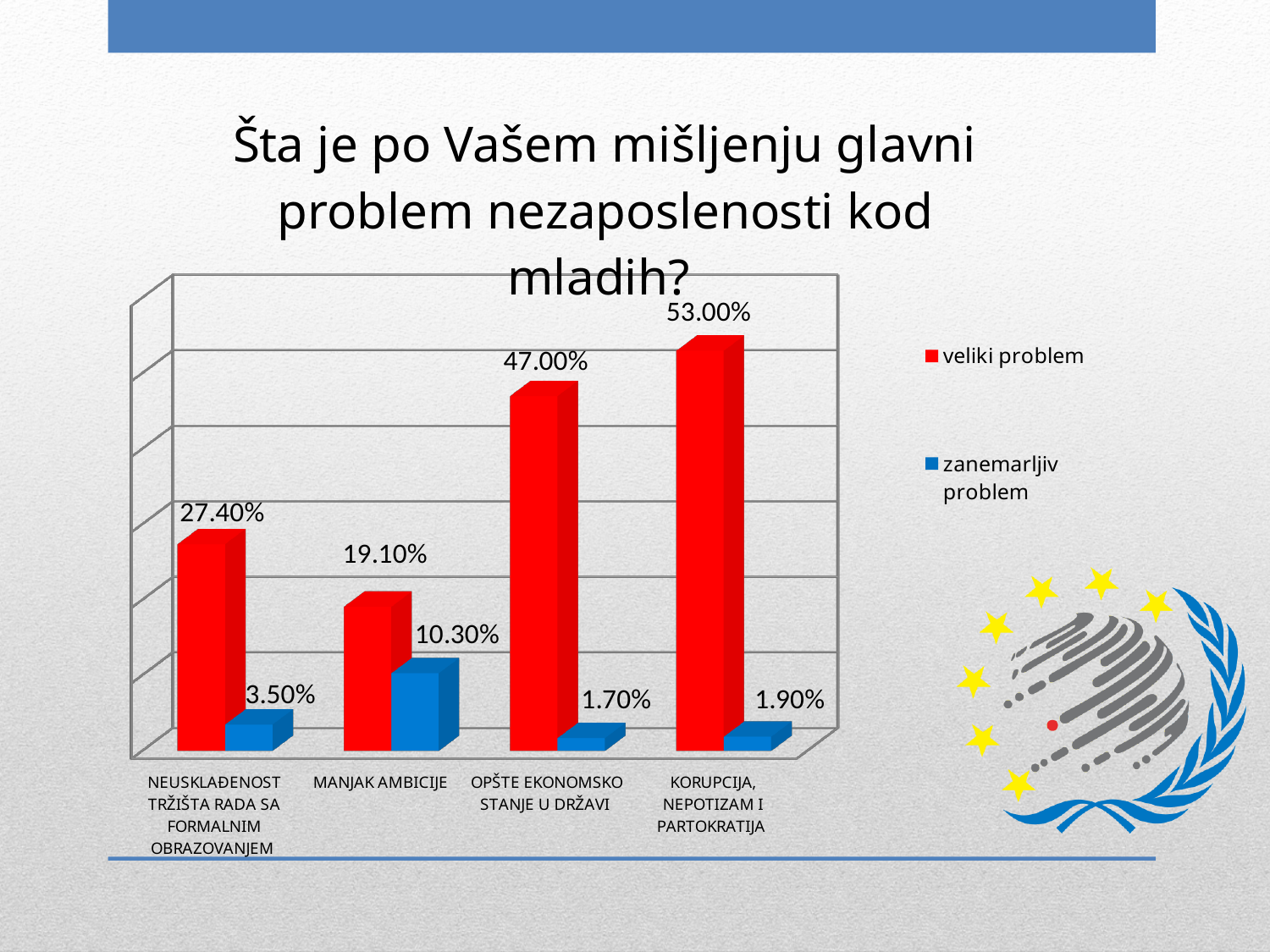
How many series does the legend list? 2 What is the value of "zanemarljiv problem" for OPŠTE EKONOMSKO STANJE U DRŽAVI? 1.70% Which colour represents the "zanemarljiv problem" series? blue How many categories are shown on the x axis? 4 Which is larger: the "veliki problem" value for MANJAK AMBICIJE or for NEUSKLAĐENOST TRŽIŠTA RADA SA FORMALNIM OBRAZOVANJEM? NEUSKLAĐENOST TRŽIŠTA RADA SA FORMALNIM OBRAZOVANJEM What is the value of "zanemarljiv problem" for MANJAK AMBICIJE? 10.30% What is the value of "veliki problem" for NEUSKLAĐENOST TRŽIŠTA RADA SA FORMALNIM OBRAZOVANJEM? 27.40% Which category has the lowest "zanemarljiv problem" value? OPŠTE EKONOMSKO STANJE U DRŽAVI What is the value of "veliki problem" for KORUPCIJA, NEPOTIZAM I PARTOKRATIJA? 53.00% What kind of chart is shown on the slide? bar chart Which category has the highest "veliki problem" value? KORUPCIJA, NEPOTIZAM I PARTOKRATIJA What is the difference between the "veliki problem" values for KORUPCIJA, NEPOTIZAM I PARTOKRATIJA and OPŠTE EKONOMSKO STANJE U DRŽAVI? 6.00%